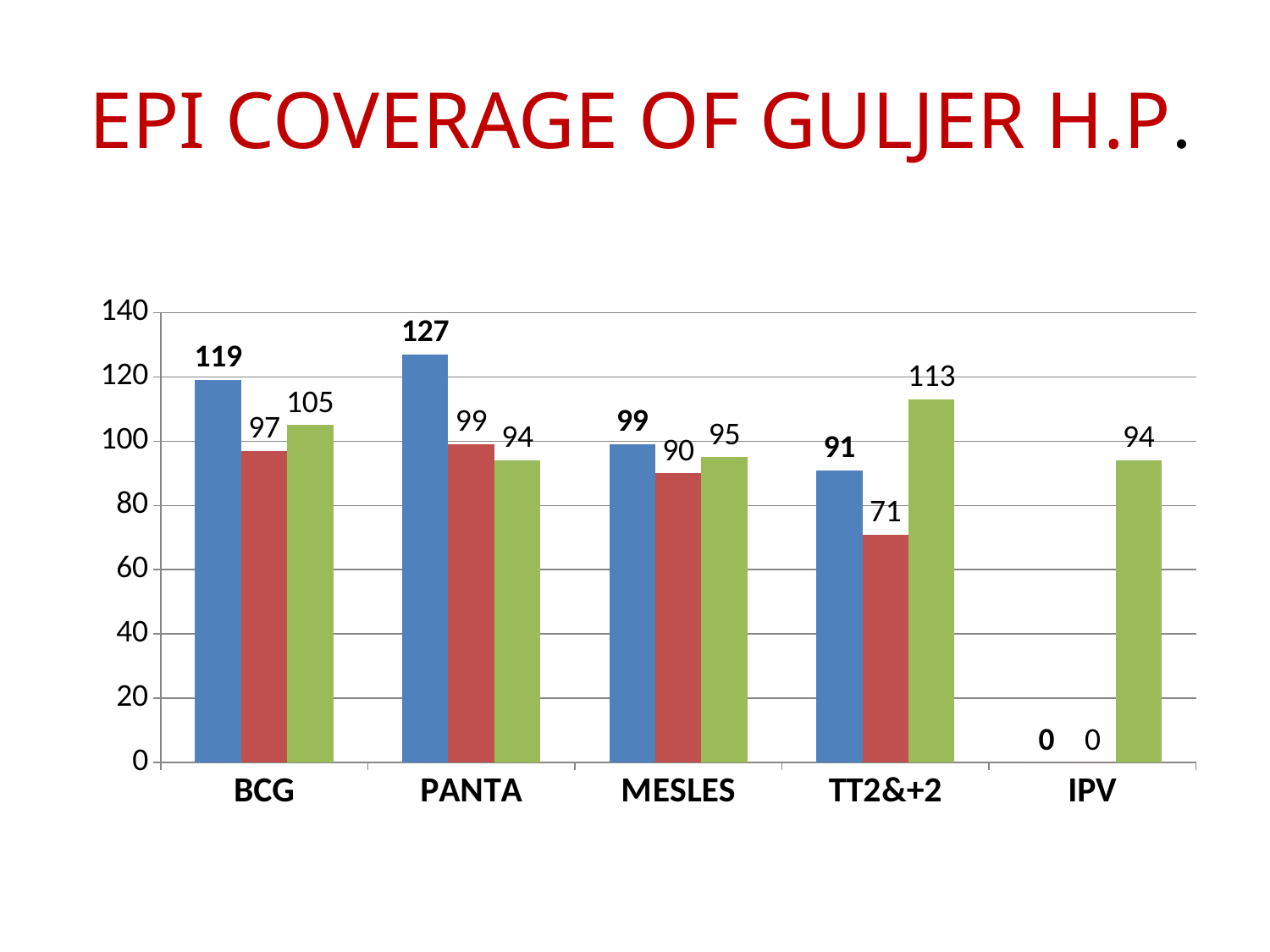
What is the difference between the blue bar for PANTA and the blue bar for BCG? 8 What kind of chart is shown on the slide? bar chart Which is larger for TT2&+2: the blue bar or the green bar? the green bar What is the value of the blue bar for BCG? 119 How many bars are shown for each category? 3 Which category has the lowest red bar? IPV What is the title of the slide containing the chart? EPI COVERAGE OF GULJER H.P. What is the value of the green bar for IPV? 94 Which category has the highest blue bar? PANTA What is the difference between the green bar for TT2&+2 and the red bar for TT2&+2? 42 How many categories are shown on the x axis? 5 What is the value of the red bar for TT2&+2? 71